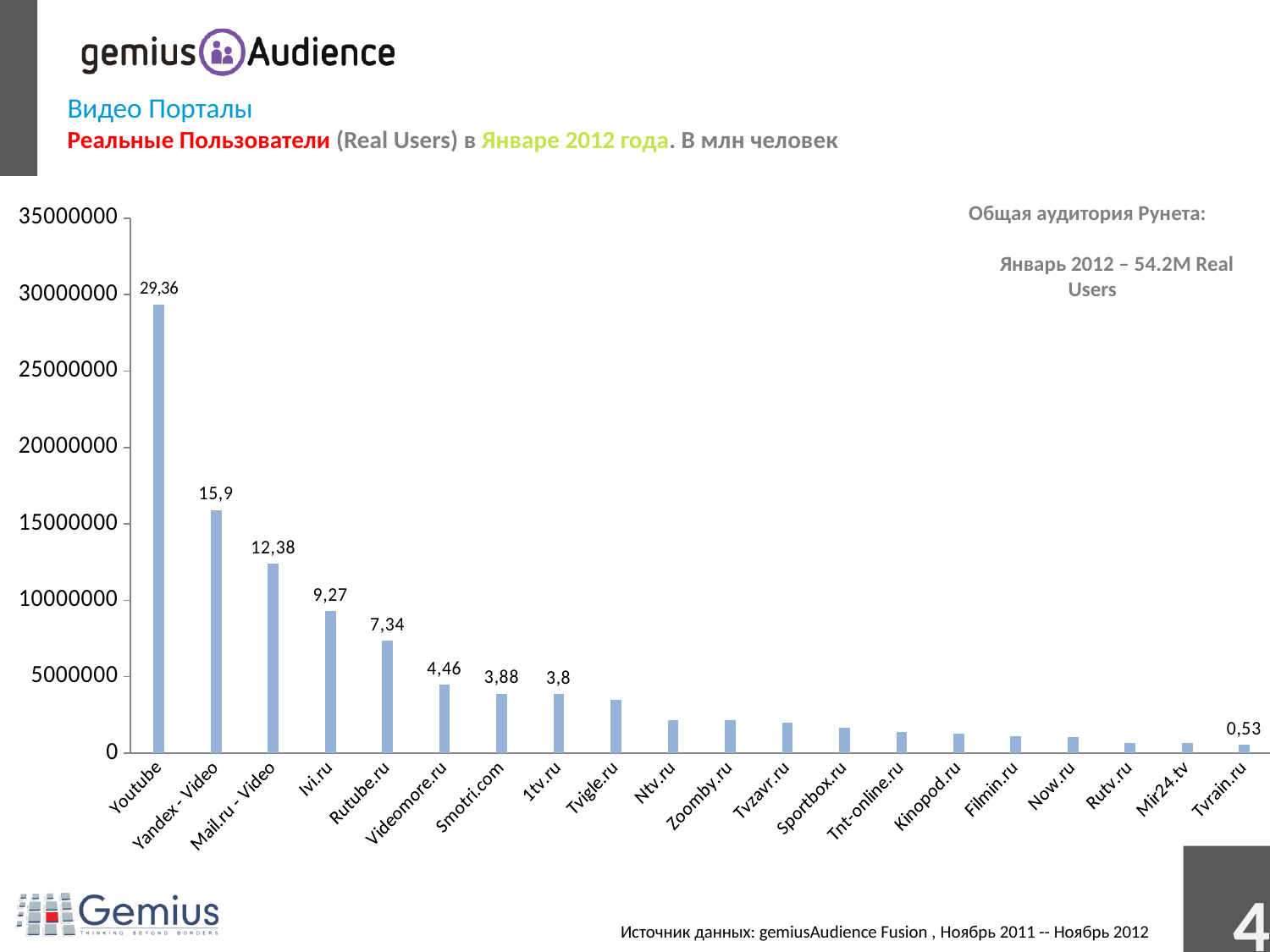
What kind of chart is shown on the slide? bar chart Which video portal has the lowest number of real users? Tvrain.ru What is the value shown for Youtube? 29,36 What is the value shown for Tvrain.ru? 0,53 What is the value shown for Mail.ru - Video? 12,38 What is the difference between the values for Ivi.ru and Rutube.ru? 1,93 Which has a larger value, Videomore.ru or Smotri.com? Videomore.ru Is the value for Tvigle.ru greater or less than 5000000? less What is the difference between the values for Youtube and Yandex - Video? 13,46 Which video portal has the highest number of real users? Youtube How many video portals are shown on the chart? 20 What is the value shown for Rutube.ru? 7,34